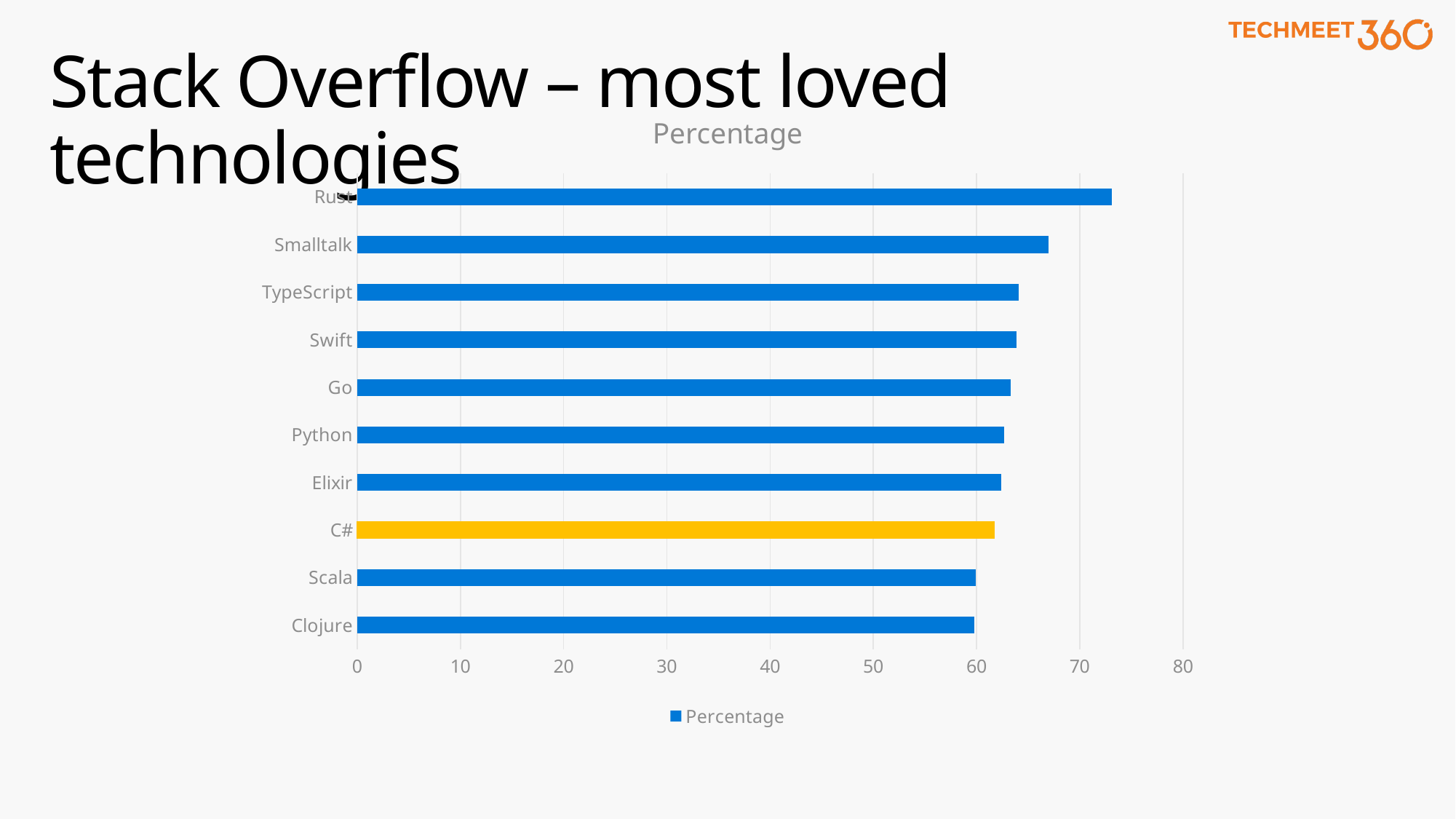
Which has a larger value, Rust or Smalltalk? Rust How many technologies are listed on the chart? 10 Is the value for Python greater or less than 60? greater Which has a larger value, Smalltalk or TypeScript? Smalltalk What kind of chart is shown on the slide? bar chart What is the title of the chart? Percentage Is the value for Rust greater or less than 70? greater Is the value for Rust greater or less than 80? less Which technology's bar is highlighted in yellow instead of blue? C# How many series does the legend list? 1 Which technology has the highest percentage? Rust